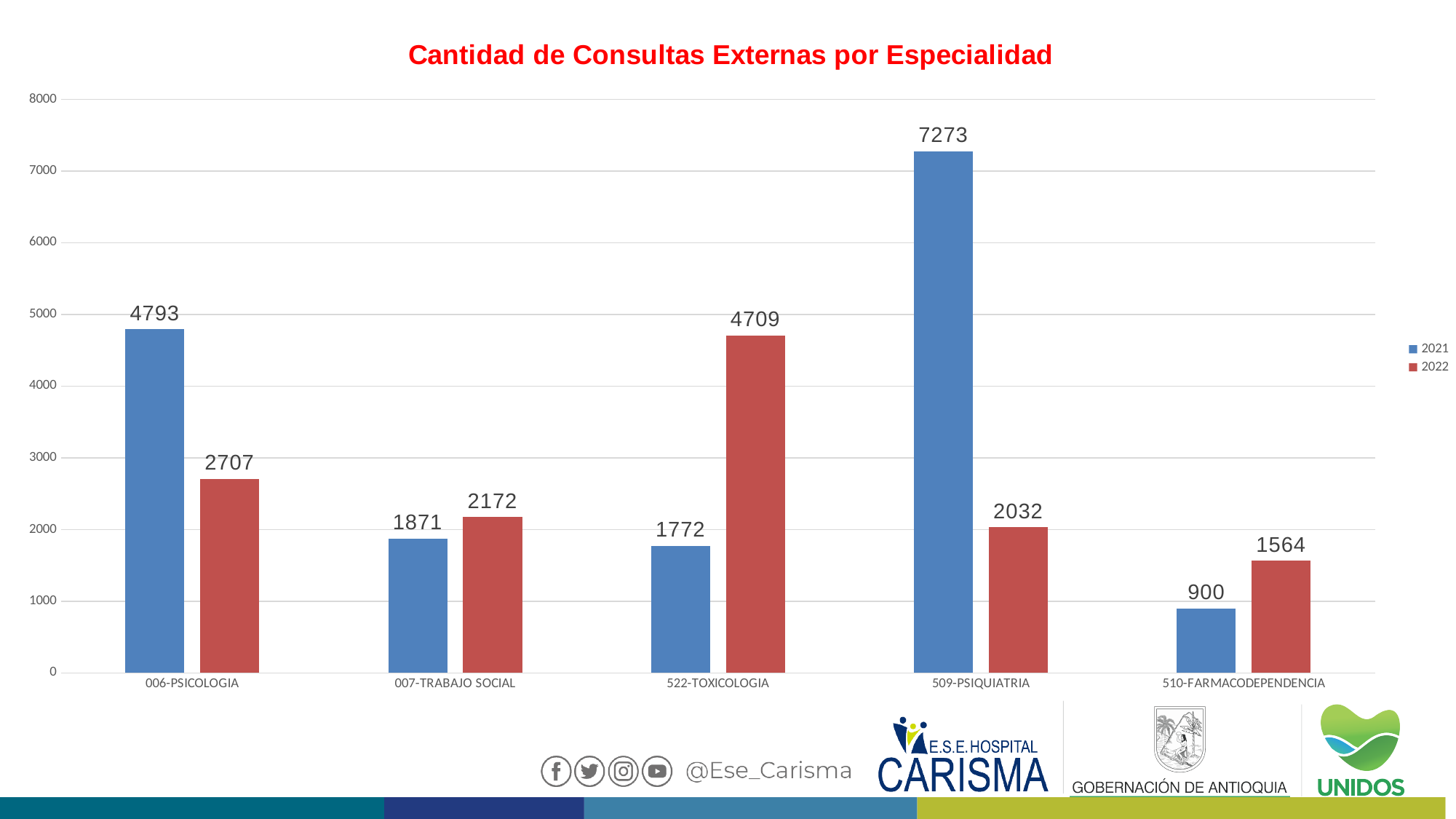
What is the 2021 value for 006-PSICOLOGIA? 4793 How many categories are shown on the x axis? 5 What kind of chart is shown? bar chart Which is larger for 007-TRABAJO SOCIAL, the 2021 value or the 2022 value? 2022 What is the title of the chart? Cantidad de Consultas Externas por Especialidad Which category has the lowest 2022 value? 510-FARMACODEPENDENCIA How many series does the legend list? 2 What is the difference between the 2021 and 2022 values for 006-PSICOLOGIA? 2086 Which category has the highest 2021 value? 509-PSIQUIATRIA What is the difference between the 2021 and 2022 values for 509-PSIQUIATRIA? 5241 What is the 2022 value for 522-TOXICOLOGIA? 4709 What is the 2021 value for 510-FARMACODEPENDENCIA? 900